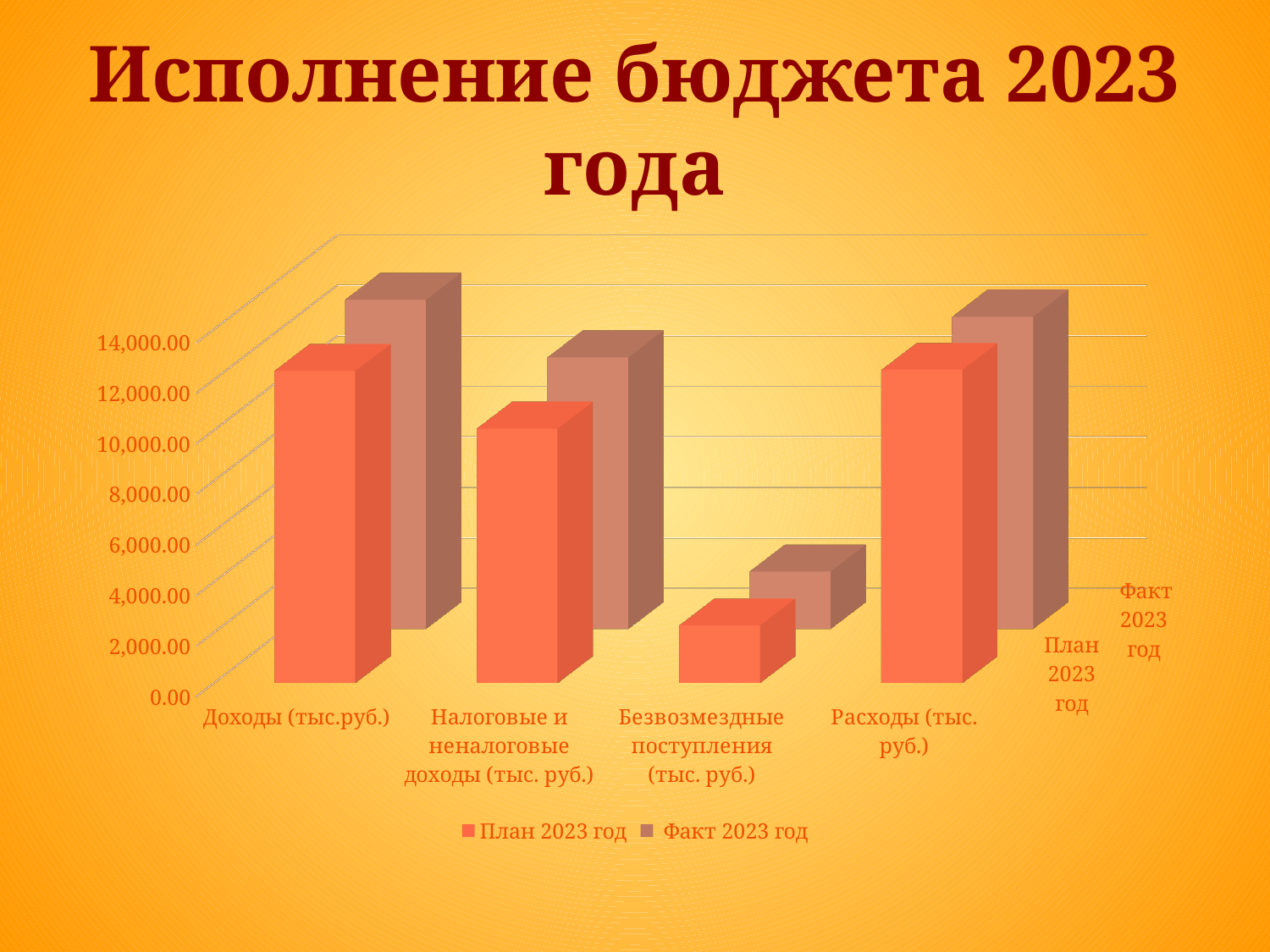
What is the title of the slide? Исполнение бюджета 2023 года Is the value for План 2023 год in Налоговые и неналоговые доходы (тыс. руб.) greater or less than 8,000.00? greater Is the value for План 2023 год in Безвозмездные поступления (тыс. руб.) greater or less than 4,000.00? less Is the value for Факт 2023 год in Безвозмездные поступления (тыс. руб.) greater or less than 8,000.00? less What are the two series named in the legend? План 2023 год and Факт 2023 год What kind of chart is shown on the slide? bar chart Which category has the lowest value for Факт 2023 год? Безвозмездные поступления (тыс. руб.) How many categories are shown on the x axis? 4 How many series does the legend list? 2 Which category has the lowest value for План 2023 год? Безвозмездные поступления (тыс. руб.)